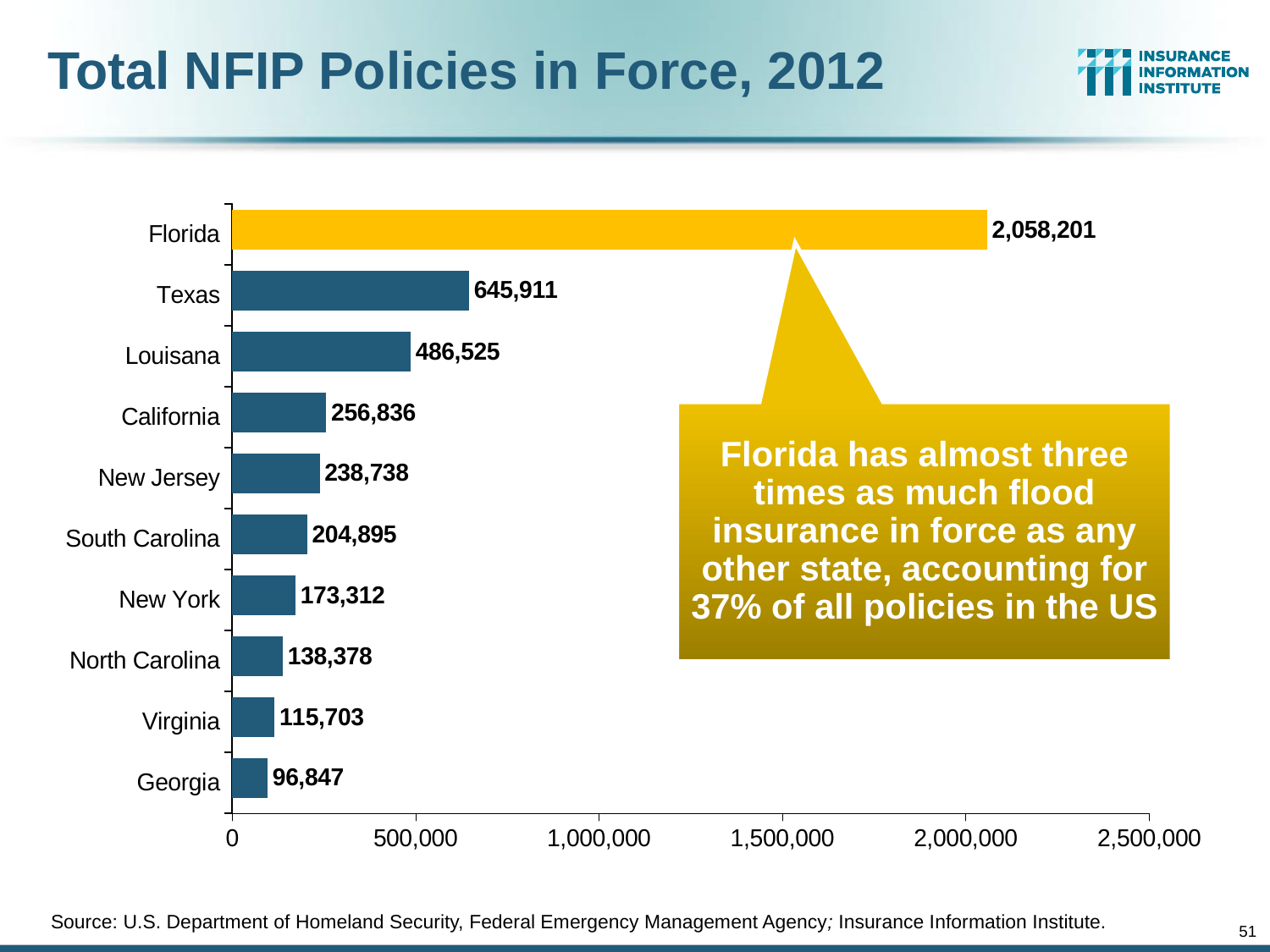
Which has more NFIP policies in force, California or New Jersey? California Which state has the lowest number of NFIP policies in force? Georgia What is the difference between the number of policies in Florida and Texas? 1,412,290 What is the number of NFIP policies in force for Florida? 2,058,201 Which state has the highest number of NFIP policies in force? Florida What is the difference between the number of policies in Texas and Louisana? 159,386 How many states are shown in the chart? 10 What is the number of NFIP policies in force for Louisana? 486,525 According to the callout on the slide, what share of all US policies does Florida account for? 37% What kind of chart is shown on the slide? Bar chart What is the number of NFIP policies in force for New York? 173,312 Is the value for Texas greater or less than 500,000? greater